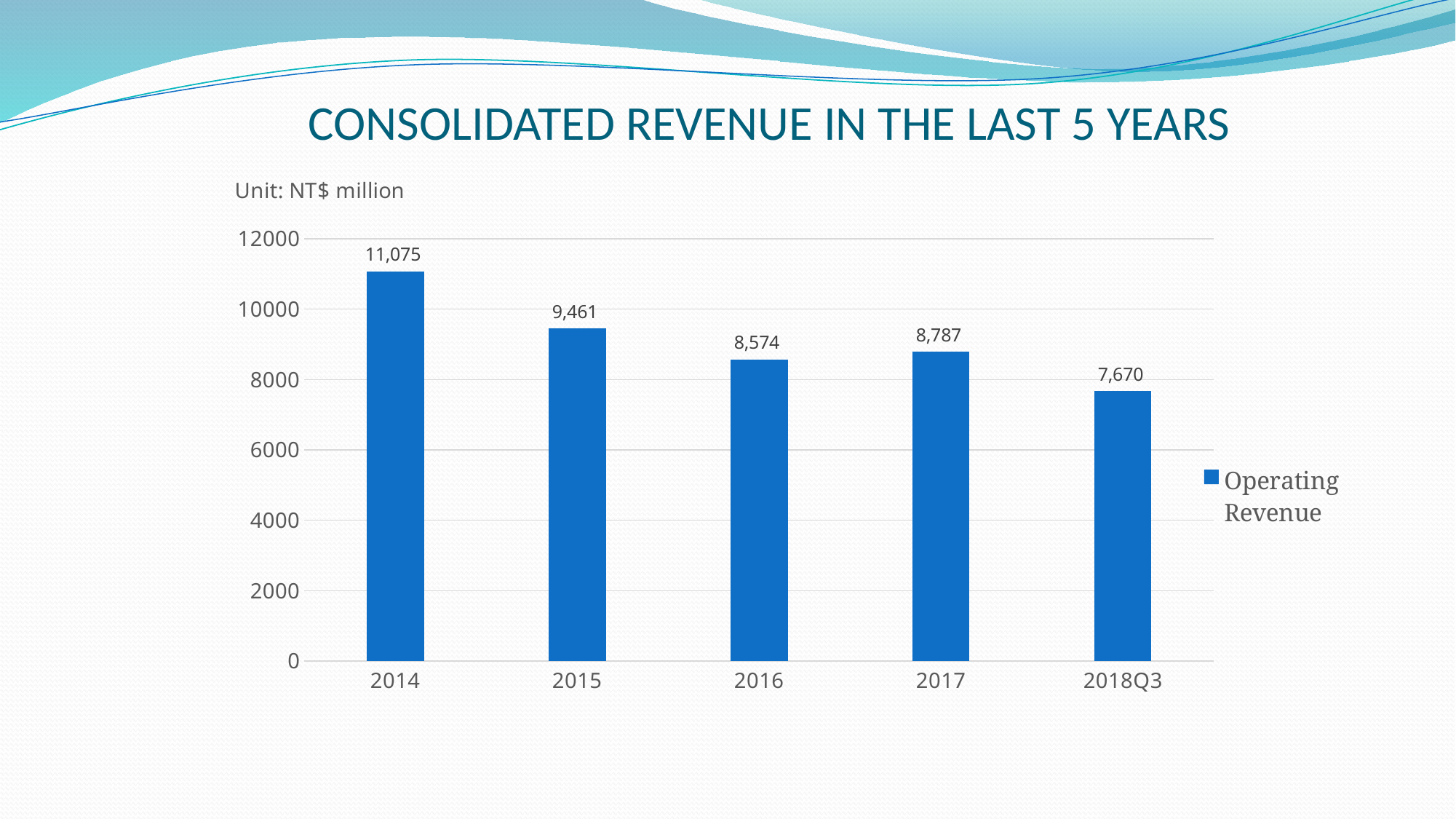
What is the Operating Revenue for 2014? 11,075 What kind of chart is shown on the slide? bar chart Is the Operating Revenue for 2018Q3 greater or less than 8000? less What is the Operating Revenue for 2016? 8,574 What is the Operating Revenue for 2018Q3? 7,670 Which year has the highest Operating Revenue? 2014 Which period has the lowest Operating Revenue? 2018Q3 Which is larger, the Operating Revenue for 2015 or for 2017? 2015 What is the difference in Operating Revenue between 2017 and 2016? 213 What is the difference in Operating Revenue between 2014 and 2015? 1,614 What unit is stated for the values in the chart? NT$ million How many periods are shown on the x axis? 5